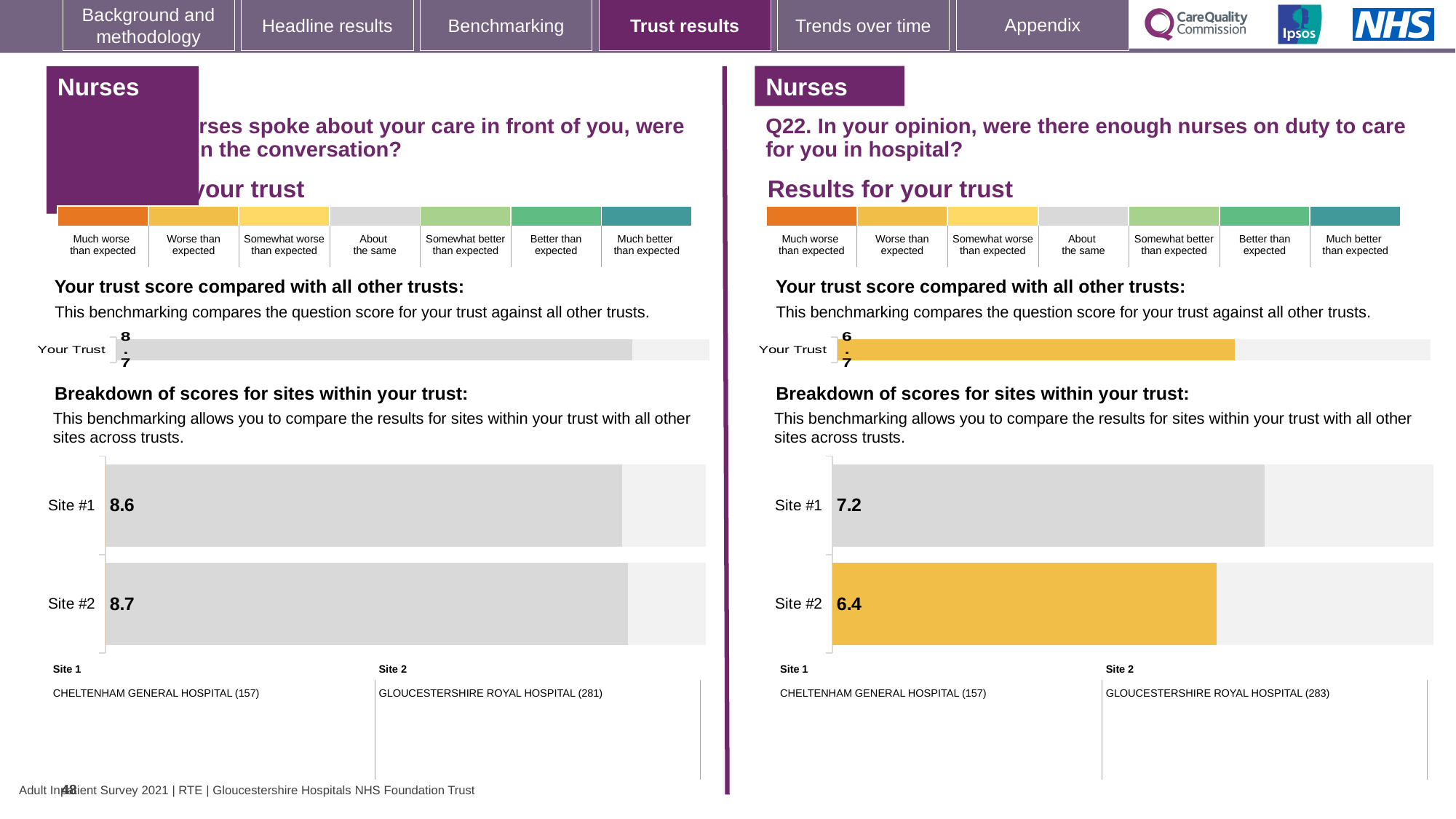
What type of chart is used for the site breakdown on the right-hand (Q22) side of the slide? Bar chart On the right-hand (Q22) site breakdown chart, what is the score for Site #2? 6.4 On the right-hand (Q22) 'Your trust score compared with all other trusts' chart, what is the score for Your Trust? 6.7 On the left-hand 'Your trust score compared with all other trusts' chart, what is the score for Your Trust? 8.7 On the left-hand site breakdown chart, what is the score for Site #2? 8.7 How many sites are shown on the right-hand (Q22) site breakdown chart? 2 On the right-hand (Q22) site breakdown chart, which site has the higher score? Site #1 On the left-hand site breakdown chart, what is the difference between the Site #2 and Site #1 scores? 0.1 On the right-hand (Q22) site breakdown chart, what is the score for Site #1? 7.2 On the right-hand (Q22) site breakdown chart, what is the difference between the Site #1 and Site #2 scores? 0.8 On the right-hand (Q22) site breakdown chart, what colour is the bar for Site #2? Yellow On the left-hand site breakdown chart, what is the score for Site #1? 8.6